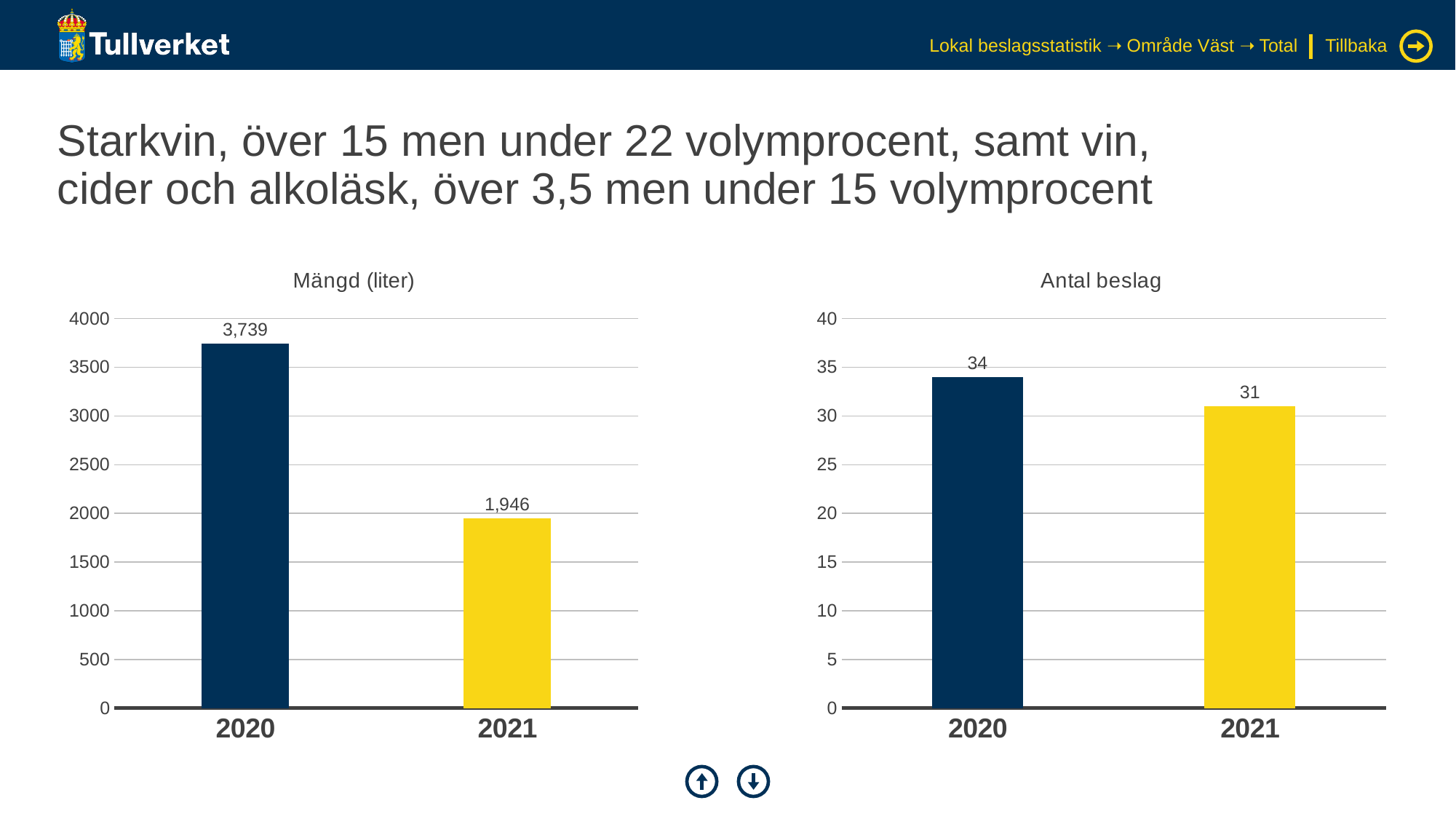
In the 'Antal beslag' chart, what is the difference between the 2020 and 2021 values? 3 In the 'Mängd (liter)' chart, what is the value for 2020? 3,739 In the 'Antal beslag' chart, is the value for 2020 greater or less than 30? greater In the 'Mängd (liter)' chart, which year has the highest value? 2020 In the 'Antal beslag' chart, what is the value for 2020? 34 In the 'Antal beslag' chart, what is the value for 2021? 31 In the 'Mängd (liter)' chart, what is the value for 2021? 1,946 How many categories are shown on the x axis of the 'Mängd (liter)' chart? 2 In the 'Antal beslag' chart, which year has the lowest value? 2021 In the 'Mängd (liter)' chart, do the values rise or fall from 2020 to 2021? fall What kind of chart is the 'Antal beslag' chart? bar chart In the 'Mängd (liter)' chart, what is the difference between the 2020 and 2021 values? 1,793